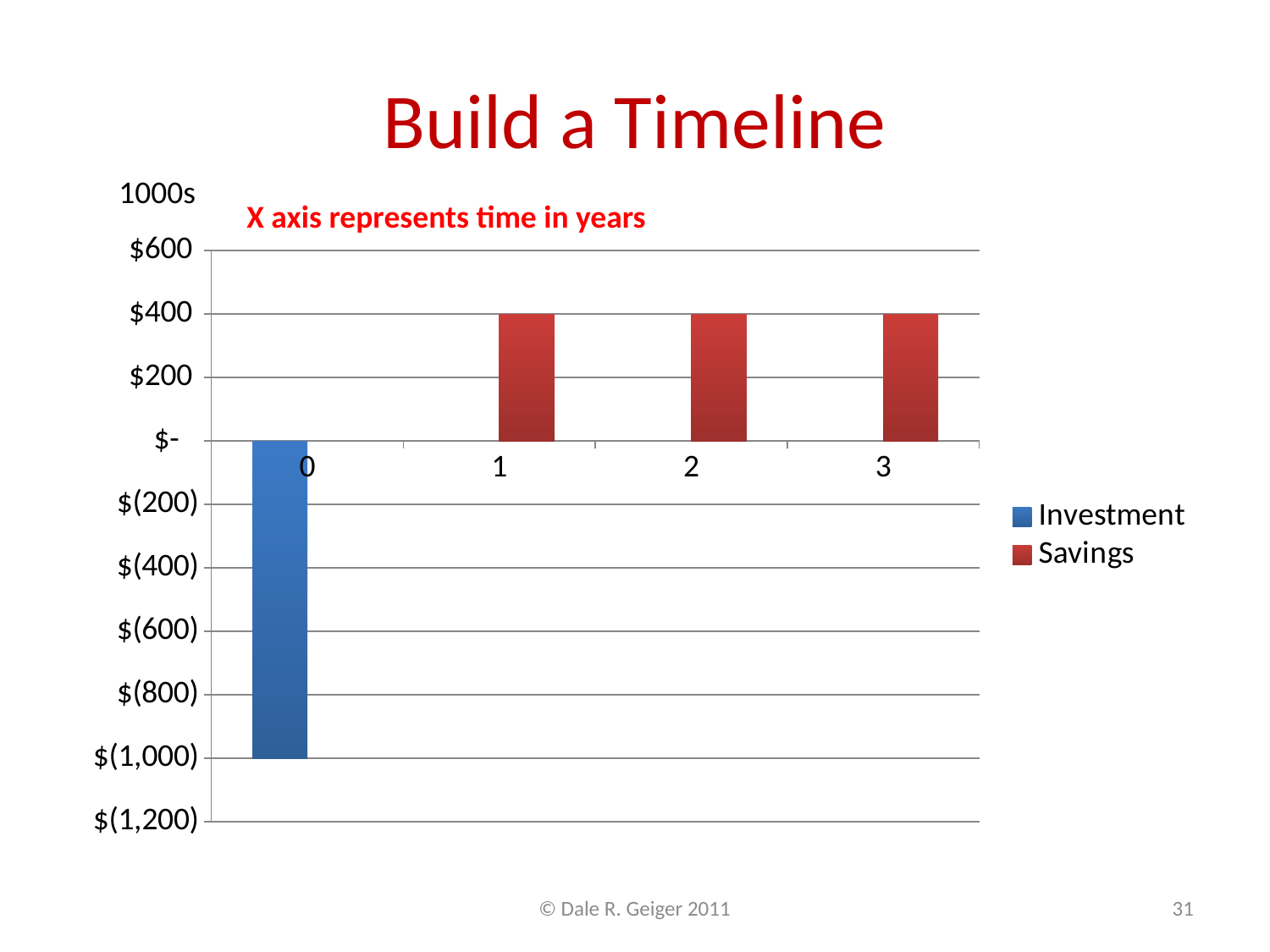
What is the difference between the Savings value at year 1 and the Savings value at year 2? $0 In which year does the Investment series have a bar? 0 What kind of chart is shown on the slide? bar chart Is the Savings value at year 2 greater or less than $200? greater How many years (categories) are shown on the x axis? 4 What is the value of the Savings bar at year 3? $400 How many series does the legend list? 2 What are the two series named in the legend? Investment and Savings What is the value of the Investment bar at year 0? $(1,000) Which is larger, the Savings value at year 1 or the Investment value at year 0? Savings at year 1 What is the value of the Savings bar at year 1? $400 Do the Savings values rise, fall, or stay the same from year 1 to year 3? stay the same